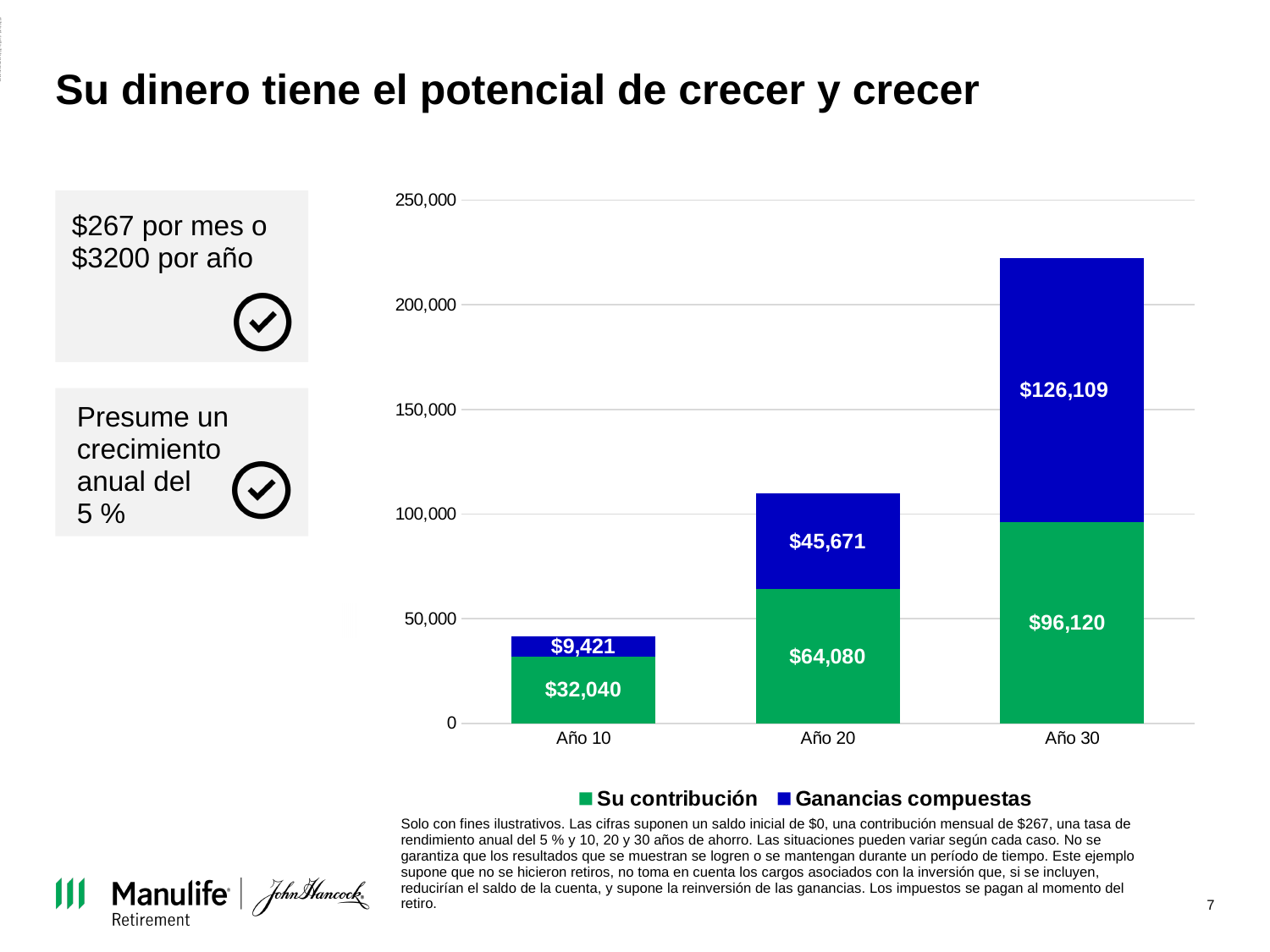
Which category has the highest value for Ganancias compuestas? Año 30 Which category has the lowest value for Su contribución? Año 10 What is the value of Ganancias compuestas for Año 30? $126,109 What is the difference between Su contribución for Año 30 and Su contribución for Año 20? $32,040 Is the total of the stacked bar for Año 30 greater or less than 200,000? greater Which is larger for Año 30: Su contribución or Ganancias compuestas? Ganancias compuestas How many categories are shown on the x axis? 3 What kind of chart is shown on the slide? Stacked bar chart What is the value of Ganancias compuestas for Año 20? $45,671 What is the value of Su contribución for Año 10? $32,040 What is the total of the stacked bar for Año 20? $109,751 How many series does the legend list? 2